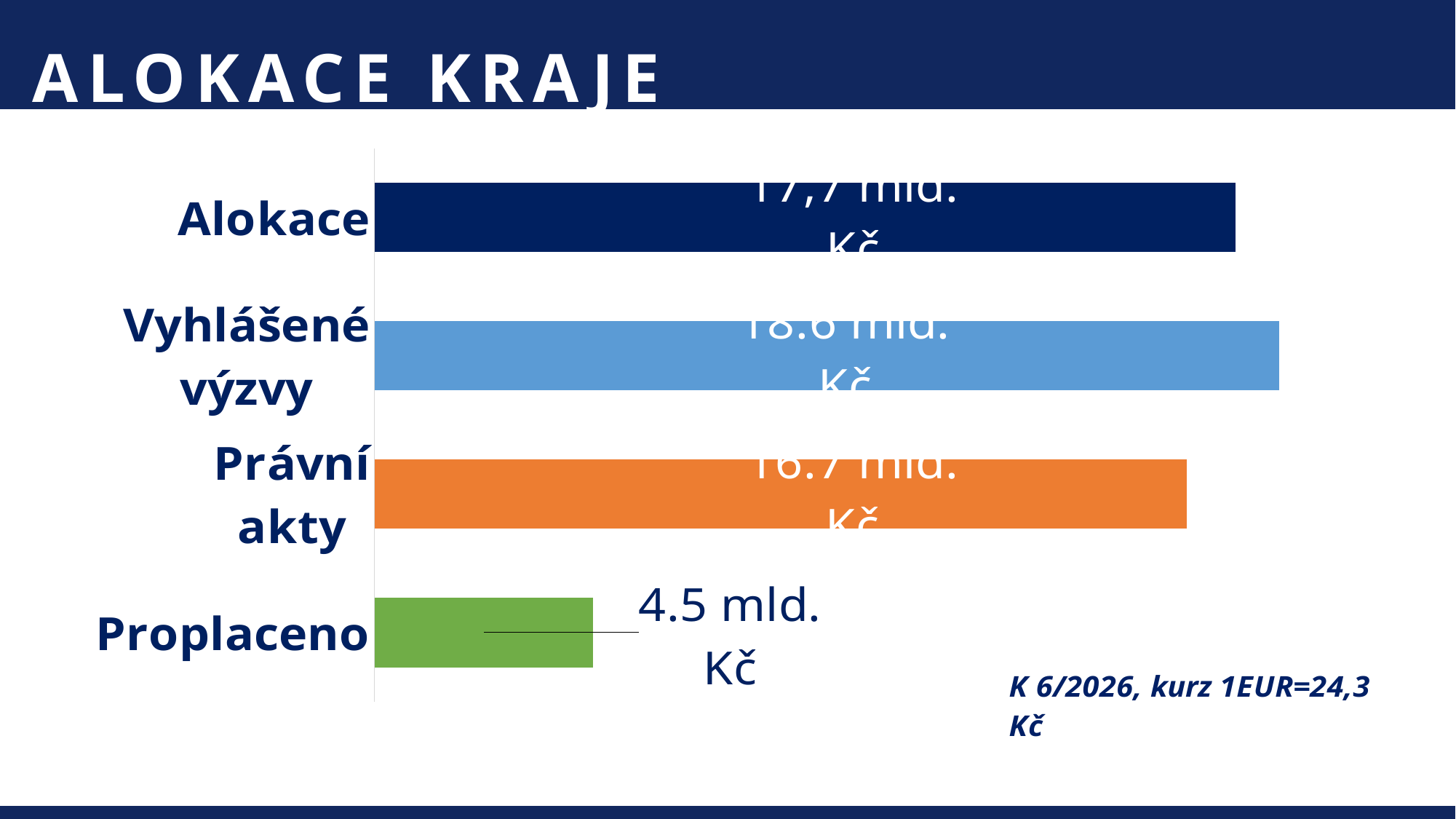
What is the title of the slide? ALOKACE KRAJE How many categories are plotted in the chart? 4 What is the value shown for Proplaceno? 4.5 mld. Kč What colour is the bar for Proplaceno? green What kind of chart is shown on the slide? bar chart Which is larger, the value for Vyhlášené výzvy or the value for Alokace? Vyhlášené výzvy Which is larger, the value for Alokace or the value for Právní akty? Alokace Which category has the shortest bar? Proplaceno Which category has the longest bar? Vyhlášené výzvy Which is larger, the value for Právní akty or the value for Proplaceno? Právní akty